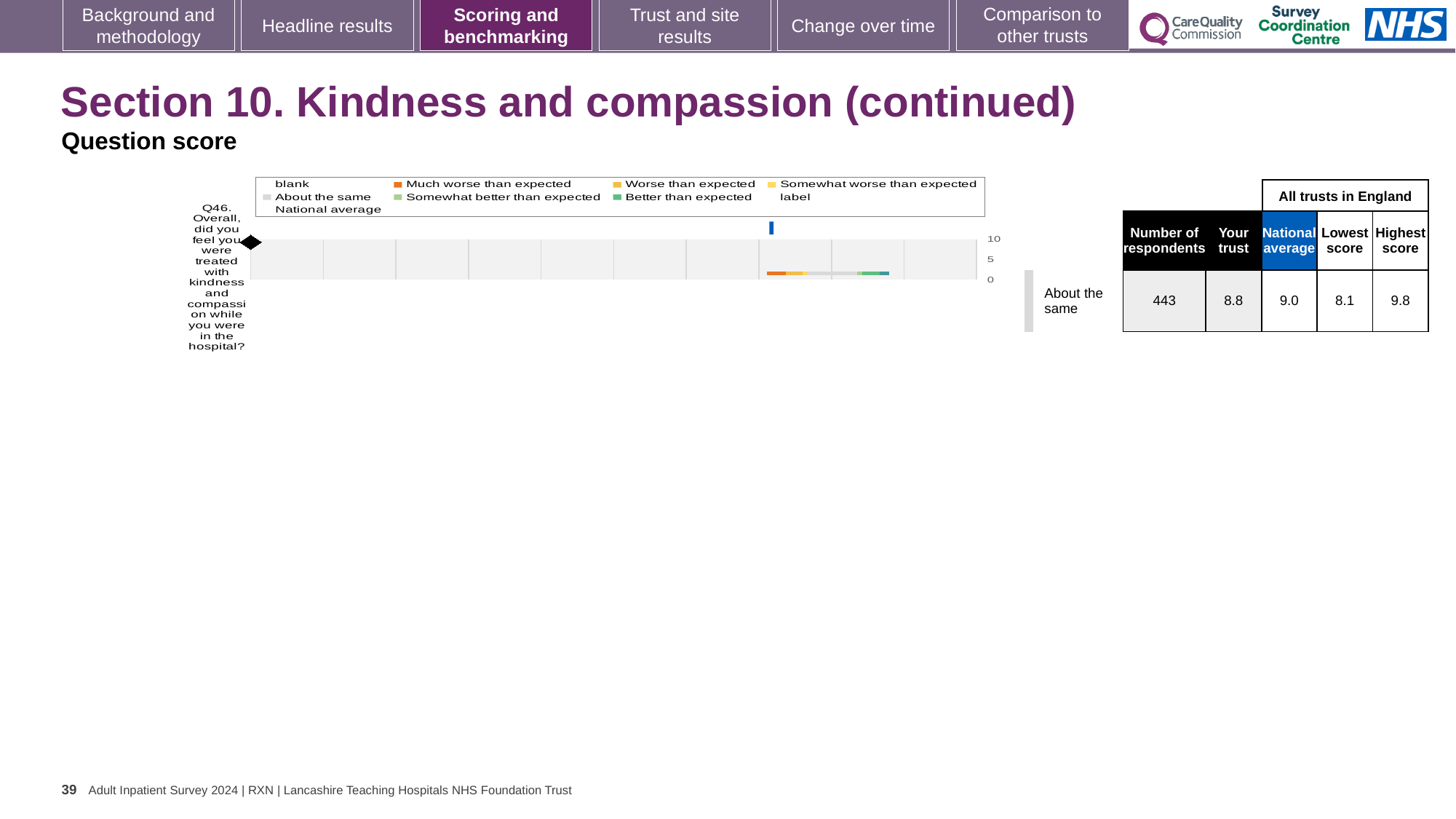
What benchmark category is given for Q46 next to the chart? About the same Which question is plotted on the chart? Q46. Overall, did you feel you were treated with kindness and compassion while you were in the hospital? What is the difference between the highest score and the lowest score for Q46 in the table next to the chart? 1.7 In the table next to the chart, what is the national average score for Q46? 9.0 What is the highest tick value shown on the chart's score axis? 10 In the table next to the chart, what is the lowest score among all trusts in England for Q46? 8.1 What kind of chart is shown on the slide for Q46? bar chart Which is larger for Q46, the 'Your trust' score or the national average? National average In the table next to the chart, what is the 'Your trust' score for Q46? 8.8 How many questions (categories) are plotted on the chart? 1 In the table next to the chart, what is the number of respondents for Q46? 443 In the table next to the chart, what is the highest score among all trusts in England for Q46? 9.8